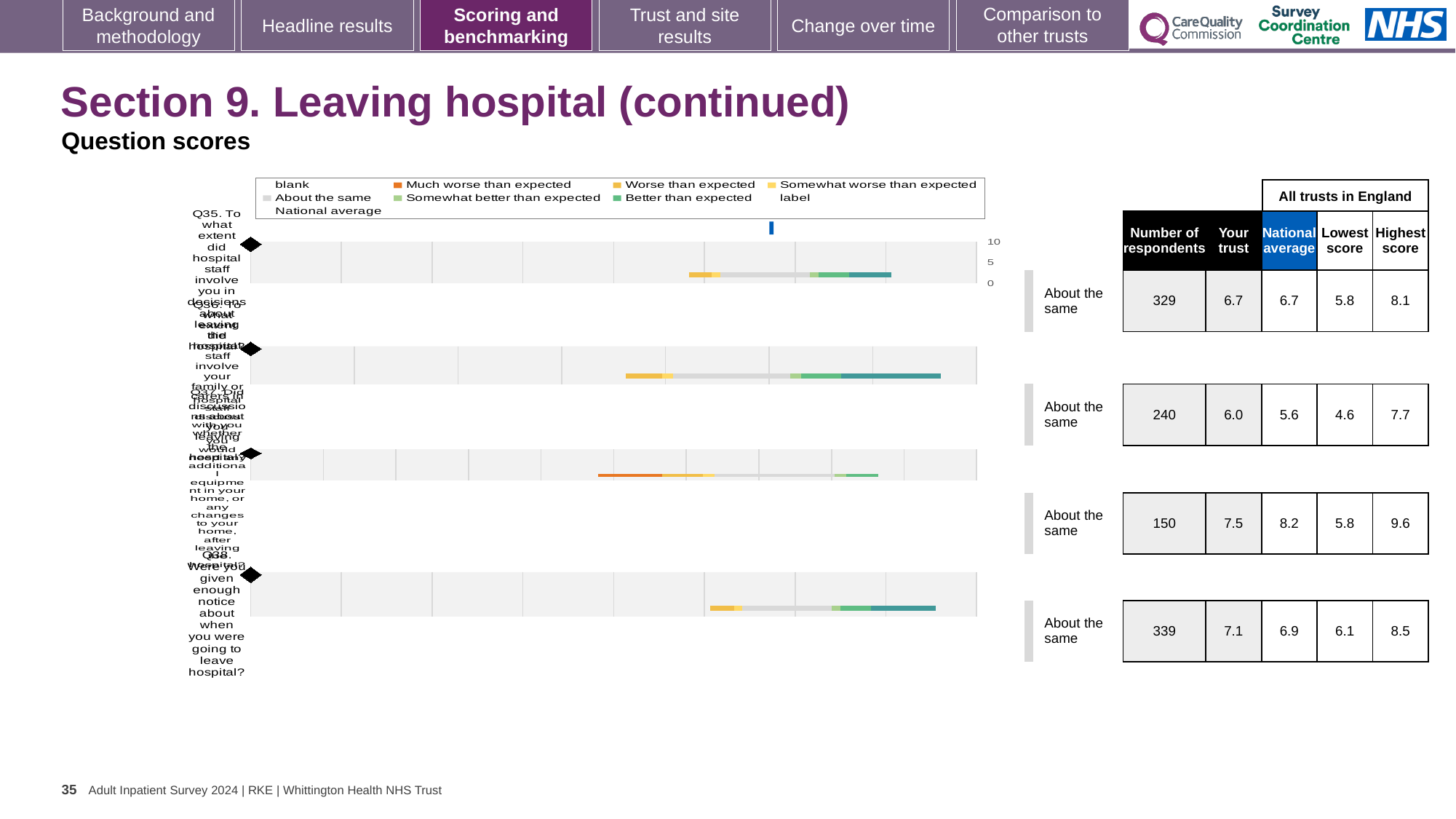
Which question has the largest number of respondents? Q38 How many questions are plotted in the chart? 4 For Q38, which is larger: the 'Your trust' score or the national average? Your trust What is the lowest score among all trusts in England for Q35? 5.8 What benchmark category is shown for Q38? About the same Is the 'Your trust' score for Q35 higher, lower or the same as the national average? the same What is the 'Your trust' score for Q38? 7.1 How many respondents are listed for Q35 in the table? 329 What is the difference between the highest and lowest scores for Q38? 2.4 What is the 'Your trust' score for Q35? 6.7 What kind of chart is used to show the question scores on this slide? bar chart What is the highest score among all trusts in England for Q38? 8.5